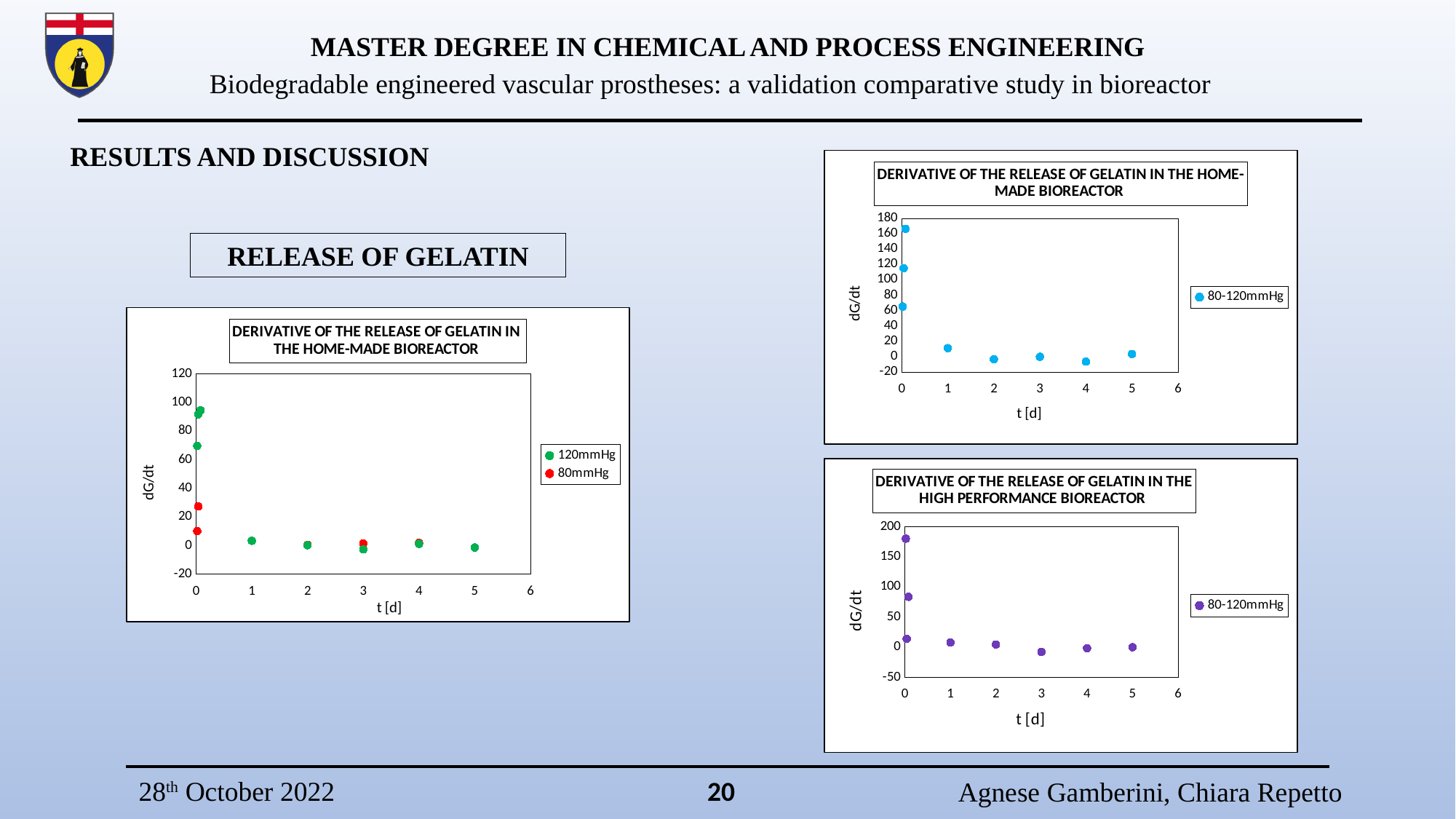
In the top-right chart (home-made bioreactor), do the dG/dt values rise or fall as t increases? fall In the top-right chart (home-made bioreactor), is the highest value at t = 0 greater or less than 140? greater In the left chart, is the highest value of the 120mmHg series at t = 0 greater or less than 80? greater In the left chart, do the dG/dt values of the 120mmHg series rise or fall as t increases from 0 to 5 days? fall In the top-right chart (home-made bioreactor), how many series does the legend list? 1 How many series does the legend of the left chart list? 2 What type of chart is the chart on the left of the slide? scatter chart In the left chart, is the highest value of the 80mmHg series at t = 0 greater or less than 40? less In the bottom-right chart (high performance bioreactor), what is the label of the x axis? t [d] In the left chart, which two series are listed in the legend? 120mmHg and 80mmHg What is the title of the bottom-right chart? DERIVATIVE OF THE RELEASE OF GELATIN IN THE HIGH PERFORMANCE BIOREACTOR